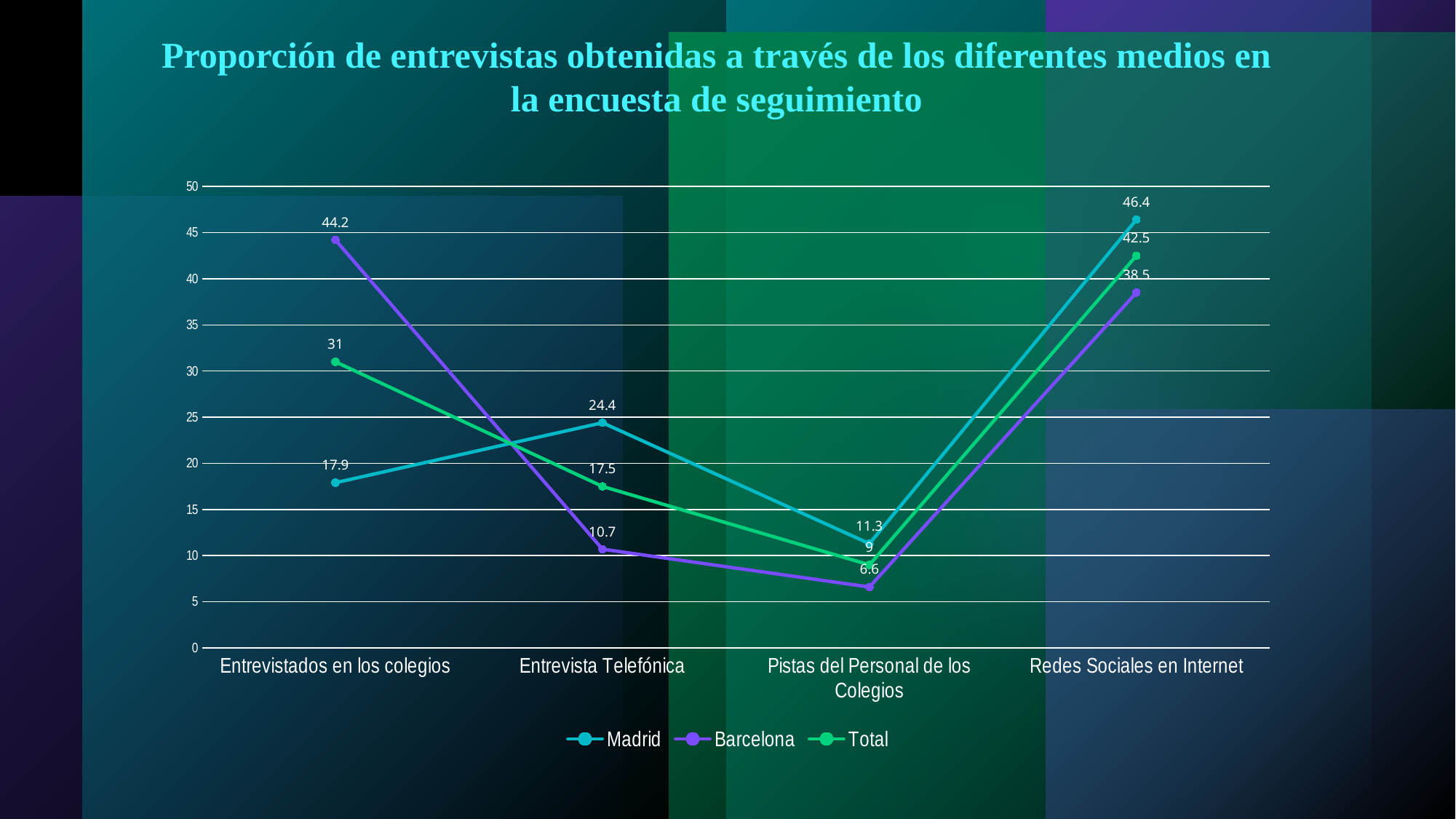
What is the value for Barcelona in the category Entrevistados en los colegios? 44.2 What is the title of the chart? Proporción de entrevistas obtenidas a través de los diferentes medios en la encuesta de seguimiento How many series does the legend list? 3 In which category does the Madrid series reach its highest value? Redes Sociales en Internet What is the difference between the Madrid and Barcelona values in the category Redes Sociales en Internet? 7.9 What is the value for Total in the category Redes Sociales en Internet? 42.5 How many categories are shown on the x axis? 4 Does the Barcelona series rise or fall from Entrevistados en los colegios to Pistas del Personal de los Colegios? fall What type of chart is shown on the slide? line chart Which is larger in the category Entrevistados en los colegios, the Madrid value or the Barcelona value? Barcelona In which category does the Barcelona series have its lowest value? Pistas del Personal de los Colegios What is the value for Madrid in the category Entrevista Telefónica? 24.4